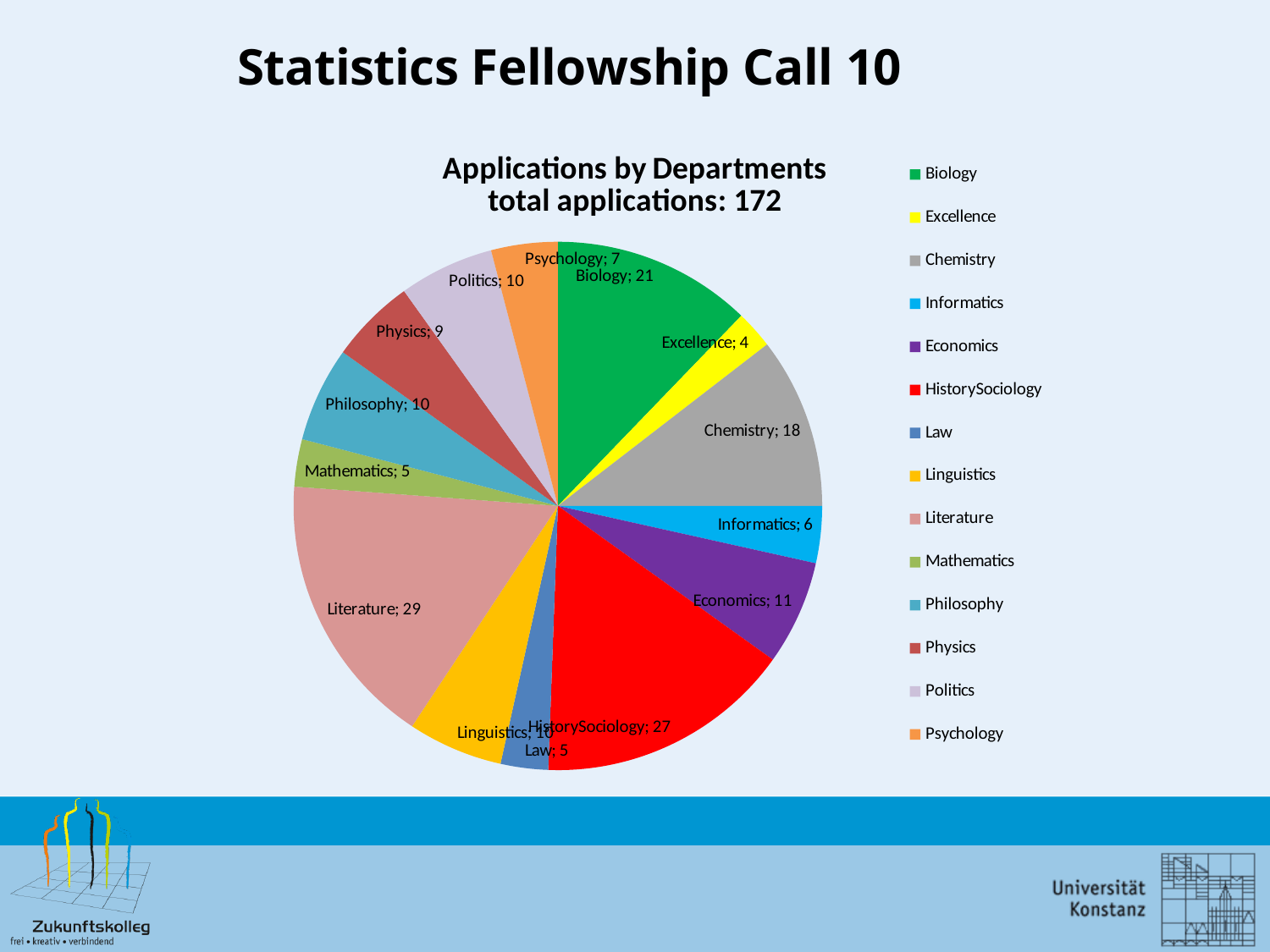
What type of chart is shown on the slide? pie chart Which is larger, the value for Economics or the value for Informatics? Economics What is the value for HistorySociology? 27 Which department has the largest slice of the pie? Literature What is the total number of applications stated in the chart title? 172 How many applications does the Literature slice show? 29 What is the difference between the values for Biology and Physics? 12 Which department has the smallest slice of the pie? Excellence What is the title of the chart? Applications by Departments total applications: 172 What colour is the HistorySociology slice? red What is the value for Chemistry? 18 How many departments are shown in the pie chart? 14